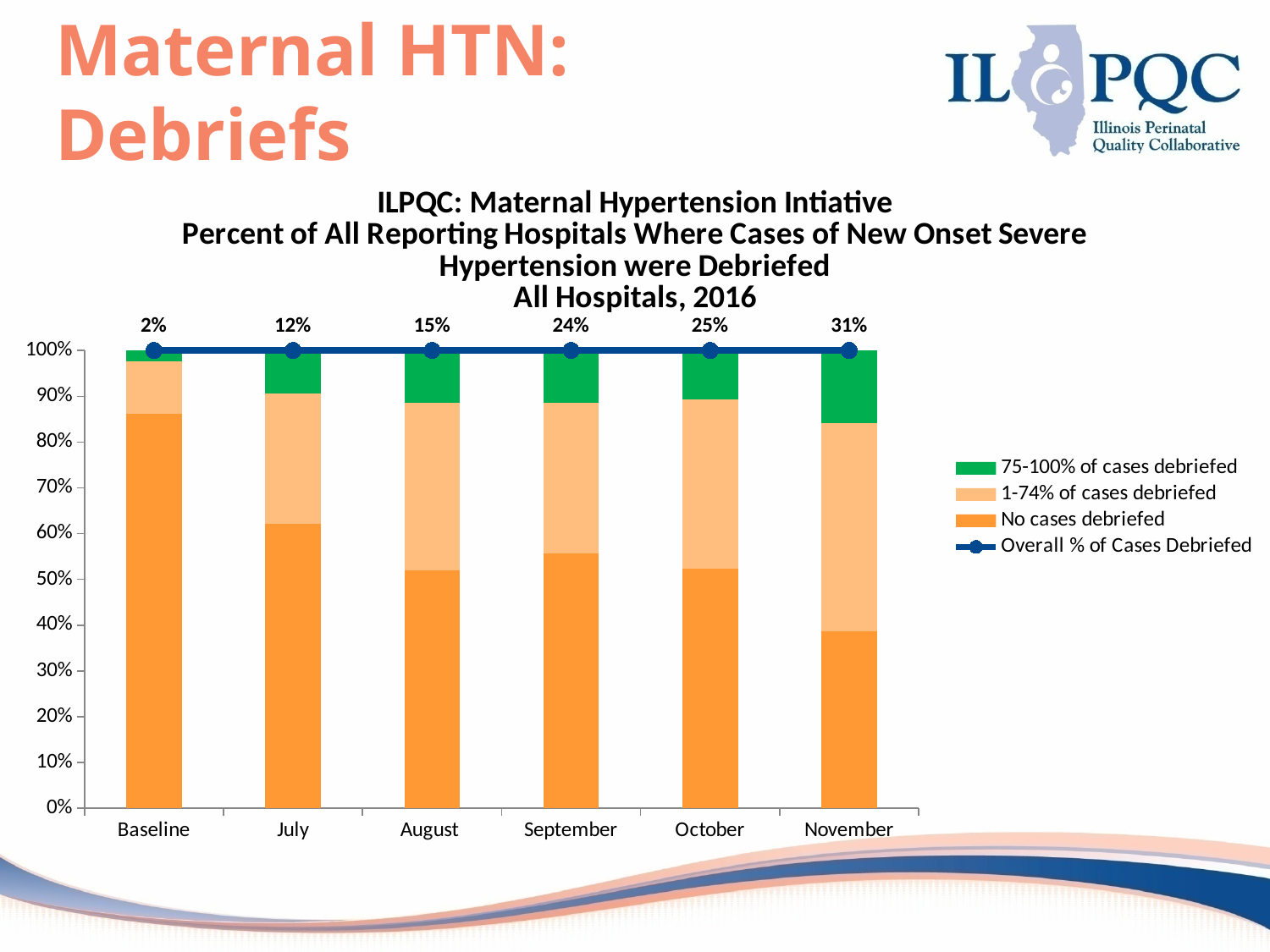
Which month has the highest Overall % of Cases Debriefed? November What is the difference in Overall % of Cases Debriefed between November and Baseline? 29% Which has a higher Overall % of Cases Debriefed, July or October? October What is the Overall % of Cases Debriefed for November? 31% Does the Overall % of Cases Debriefed rise or fall from Baseline to November? rise How many categories are shown on the x axis? 6 What is the Overall % of Cases Debriefed for Baseline? 2% How many series does the legend list? 4 Which category has the lowest Overall % of Cases Debriefed? Baseline What is the Overall % of Cases Debriefed for September? 24% Is the 'No cases debriefed' share for Baseline greater or less than 80%? greater